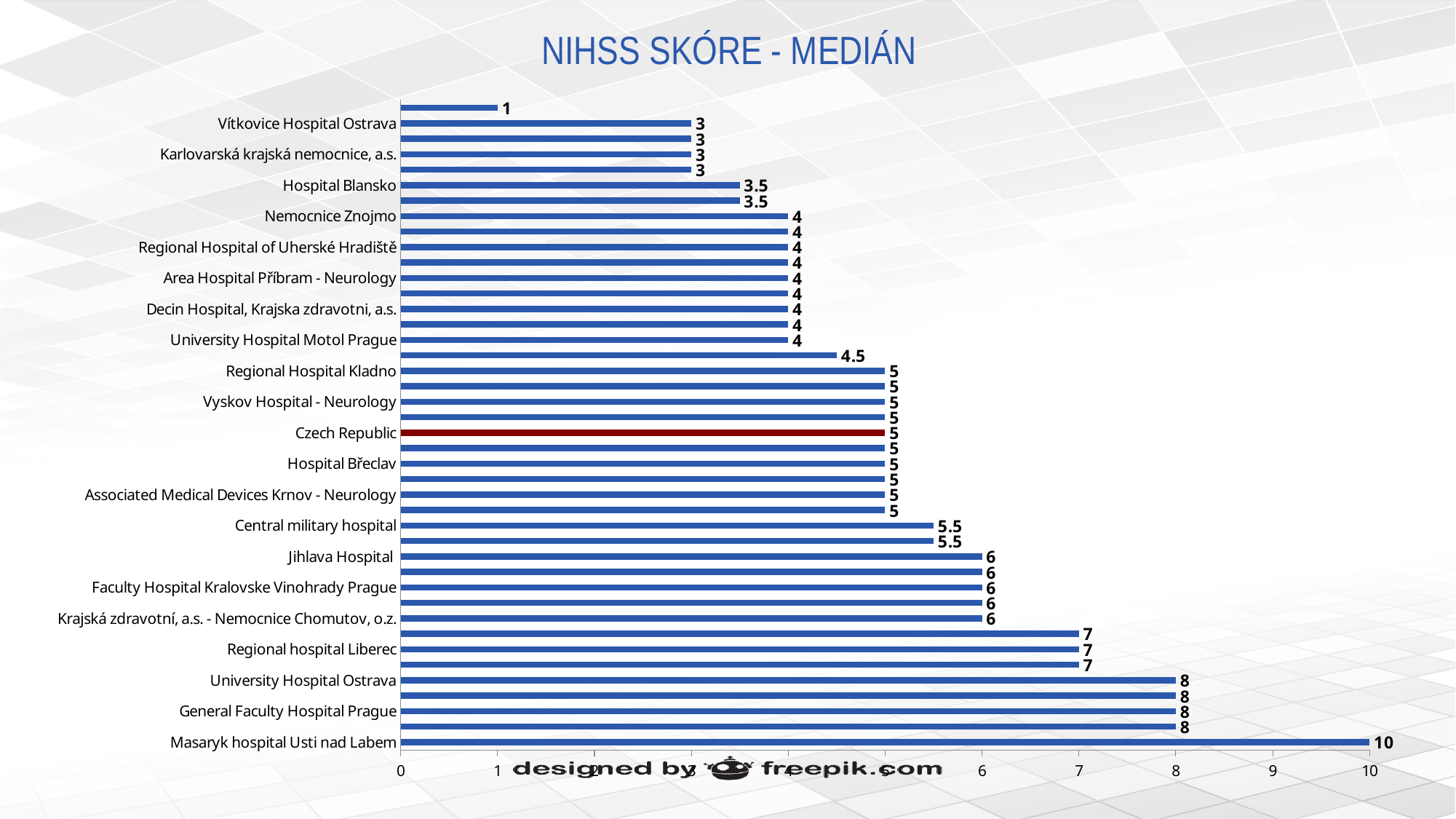
Which labelled hospital has the highest NIHSS median score? Masaryk hospital Usti nad Labem What is the title of the chart? NIHSS SKÓRE - MEDIÁN Which category's bar is coloured dark red instead of blue? Czech Republic What is the lowest NIHSS median value shown on the chart? 1 What is the NIHSS median score for Hospital Blansko? 3.5 Which has a higher NIHSS median score, Jihlava Hospital or Nemocnice Znojmo? Jihlava Hospital What is the difference between the NIHSS median score of Masaryk hospital Usti nad Labem and University Hospital Ostrava? 2 What is the NIHSS median score for Central military hospital? 5.5 What is the NIHSS median score for Regional hospital Liberec? 7 What type of chart is shown on the slide? bar chart What is the NIHSS median score for Czech Republic? 5 What is the NIHSS median score for Masaryk hospital Usti nad Labem? 10